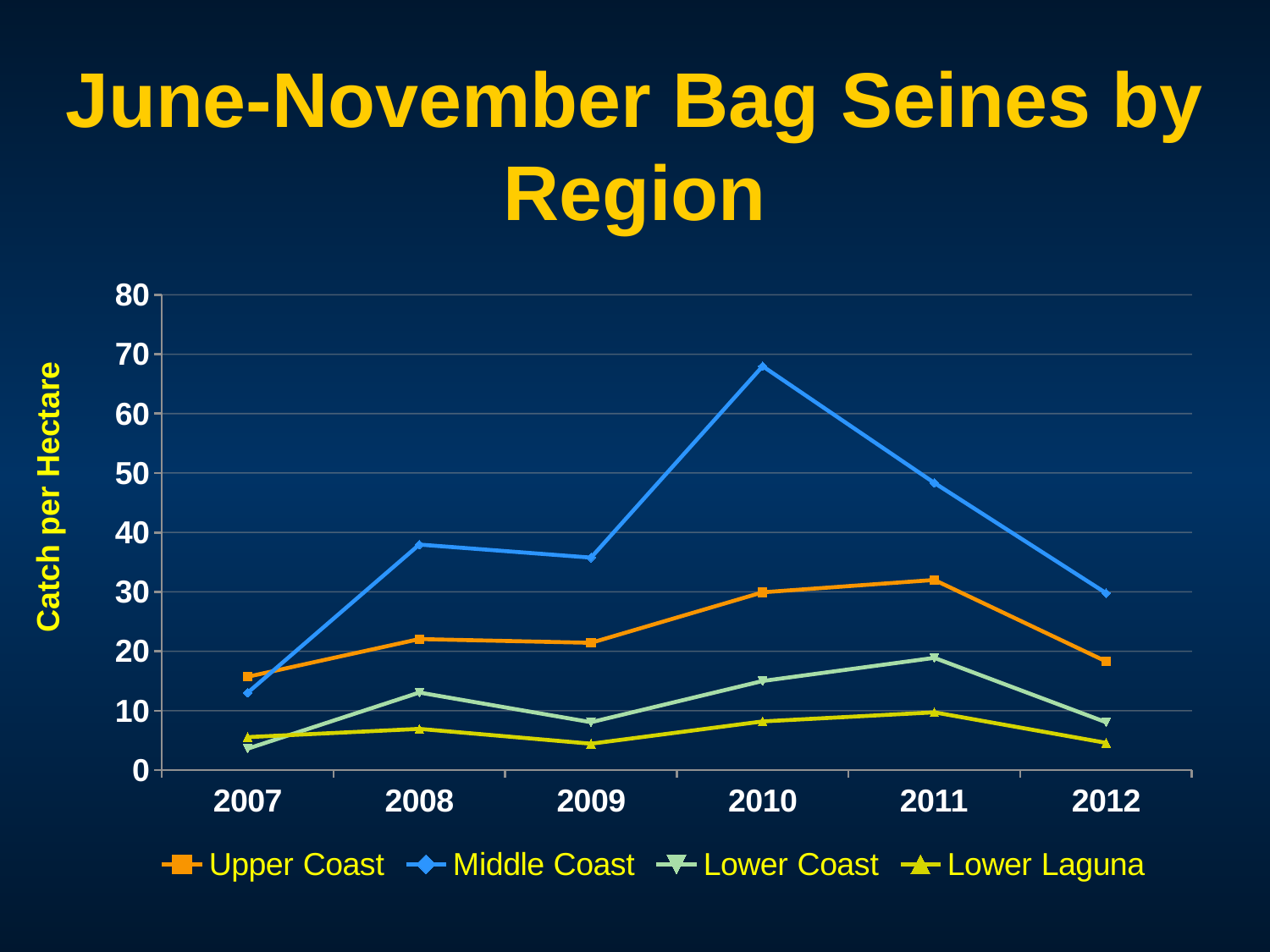
Does the Middle Coast series rise or fall from 2010 to 2012? fall Is the Middle Coast value for 2010 greater or less than 60? greater In 2012, which is higher: Middle Coast or Upper Coast? Middle Coast What kind of chart is shown on the slide? line chart Is the Middle Coast value for 2008 greater or less than 30? greater How many series does the legend list? 4 What is the label on the y axis? Catch per Hectare In 2007, which is higher: Upper Coast or Middle Coast? Upper Coast Which series has the lowest value in 2011? Lower Laguna How many years are shown on the x axis? 6 In which year does the Middle Coast series reach its highest value? 2010 Is the Upper Coast value for 2008 greater or less than 30? less